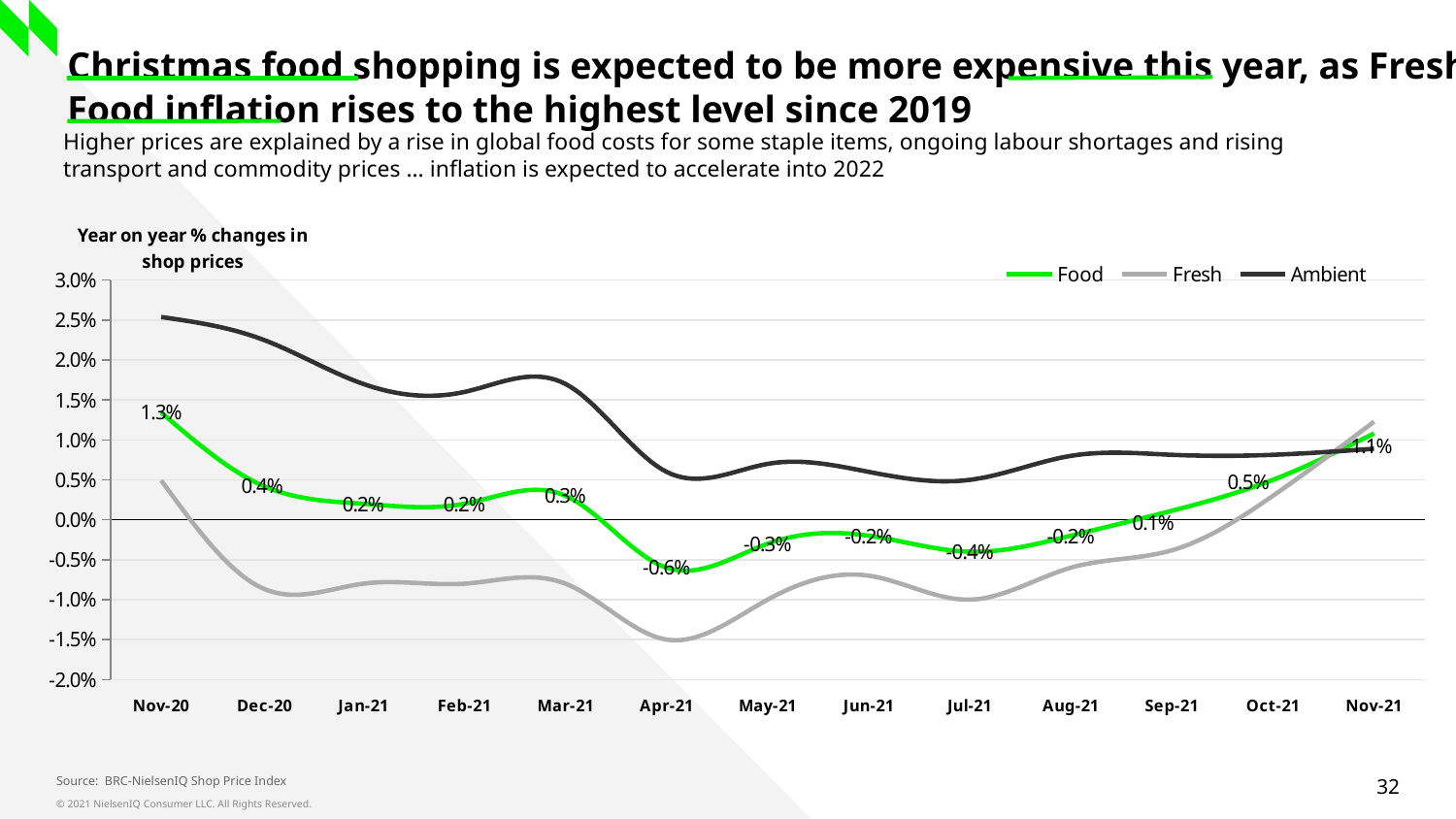
In which month is the Food series at its lowest? Apr-21 How many months are plotted along the x axis? 13 How many series does the legend list? 3 Is the Ambient value for Nov-20 greater or less than 2.0%? greater What is the Food value for Oct-21? 0.5% What kind of chart is shown on the slide? Line chart Is the Fresh value for Apr-21 greater or less than -1.0%? less What is the Food value for Apr-21? -0.6% What is the Food value for Nov-21? 1.1% Which is larger, the Food value for Dec-20 or for Sep-21? Dec-20 In which month is the Food series at its highest? Nov-20 What is the difference between the Food value in Nov-20 and in Nov-21? 0.2 percentage points